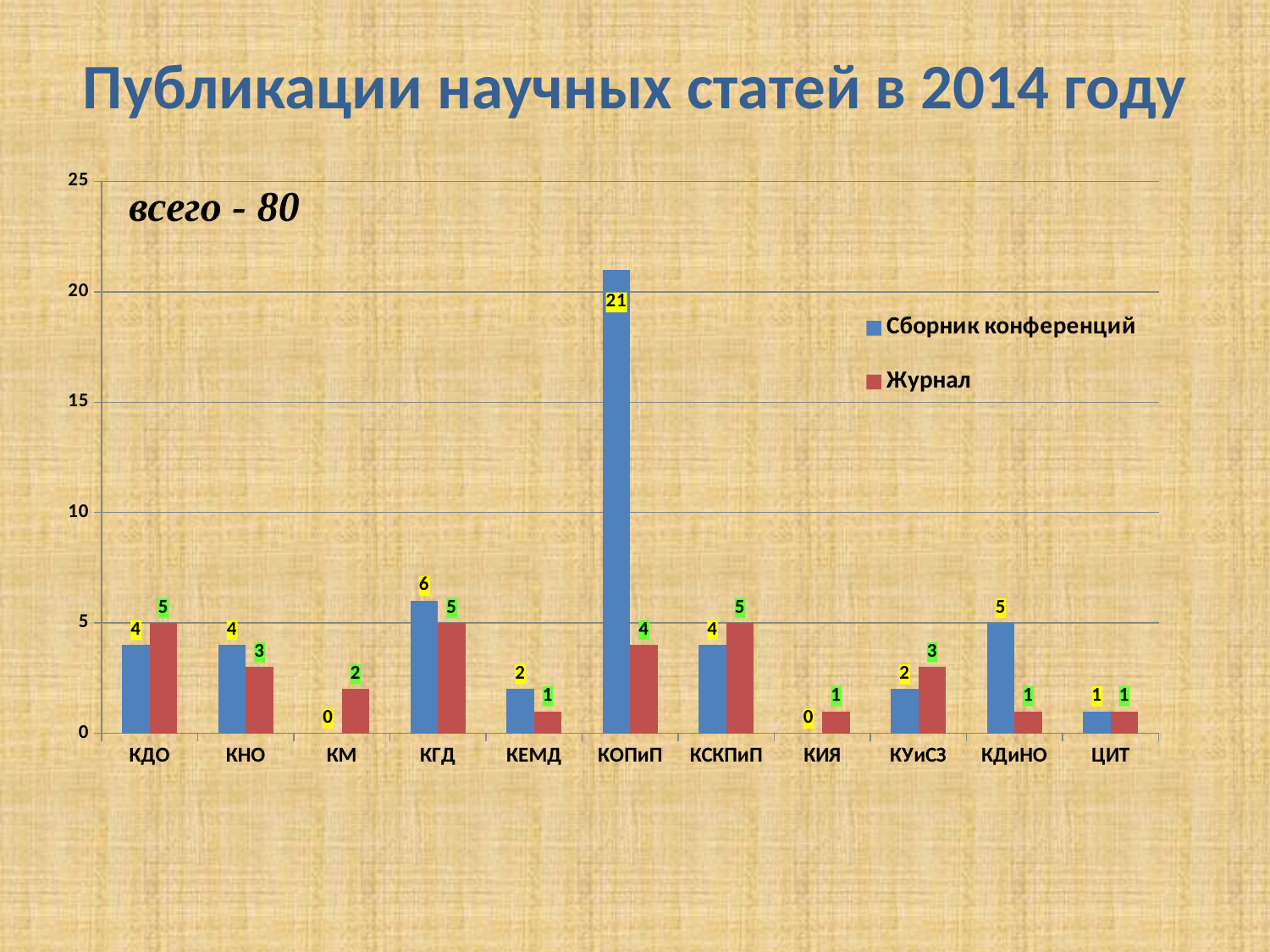
Is the value for КОПиП in the Сборник конференций series greater or less than 20? greater What is the difference between the Сборник конференций and Журнал values for КОПиП? 17 What is the value for КМ in the Сборник конференций series? 0 How many categories are shown on the x axis? 11 Which category has the highest value in the Сборник конференций series? КОПиП Which is larger for КДиНО: the Сборник конференций value or the Журнал value? Сборник конференций How many series does the legend list? 2 What is the value for КДО in the Журнал series? 5 What is the title of the slide? Публикации научных статей в 2014 году Which category has the lowest value in the Журнал series, among КДО, КНО, КМ and КГД? КМ What is the value for КОПиП in the Сборник конференций series? 21 What kind of chart is shown on the slide? bar chart